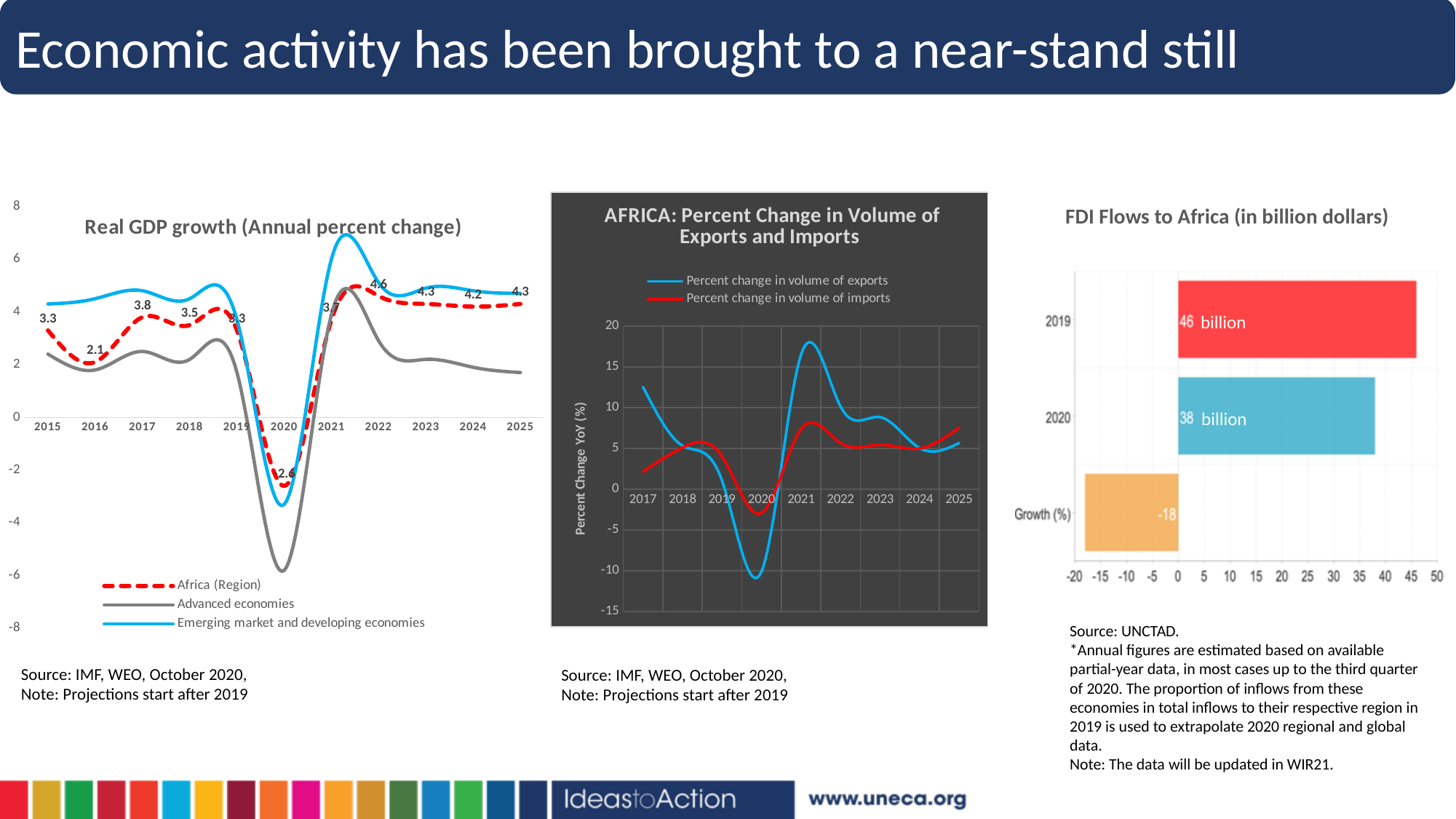
In the Real GDP growth chart, what is the difference between the Africa (Region) values for 2022 and 2020? 7.2 What kind of chart is the FDI Flows to Africa chart? bar chart How many series does the legend of the Real GDP growth chart list? 3 In the Real GDP growth chart, what is the value for Africa (Region) in 2022? 4.6 In the Real GDP growth chart, what is the value for Africa (Region) in 2020? -2.6 In the FDI Flows to Africa chart, what is the value for 2019? 46 billion In the Real GDP growth chart, in which year is the Africa (Region) value lowest? 2020 How many years are shown on the x axis of the Real GDP growth chart? 11 In the AFRICA: Percent Change in Volume of Exports and Imports chart, is the value for percent change in volume of exports in 2020 greater or less than -5? less In the FDI Flows to Africa chart, what is the difference between the 2019 and 2020 values? 8 billion What kind of chart is the AFRICA: Percent Change in Volume of Exports and Imports chart? line chart In the AFRICA: Percent Change in Volume of Exports and Imports chart, is the value for percent change in volume of exports in 2021 greater or less than 15? greater